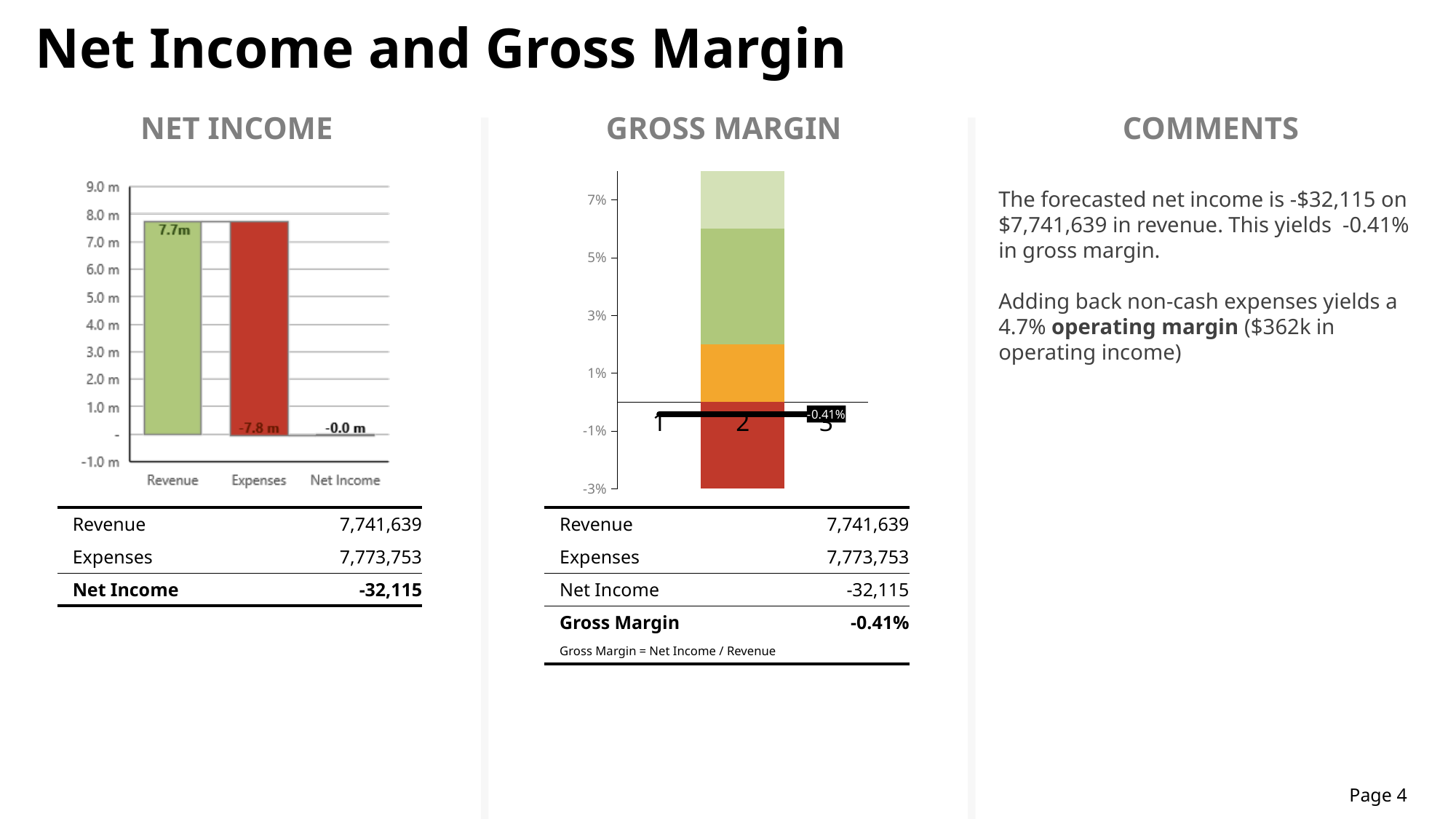
In the Net Income chart, what is the value shown for Expenses? -7.8 m In the Net Income chart, what is the value shown for Net Income? -0.0 m How many categories are shown on the x axis of the Net Income chart? 3 How many coloured bands make up the stacked bar in the Gross Margin chart? 4 In the Gross Margin chart, what value is printed on the label next to the horizontal marker line? -0.41% What kind of chart is the Net Income chart? bar chart In the Net Income chart, is the value for Revenue greater or less than 7.0 m? greater In the Net Income chart, which is larger, the value for Revenue or the value for Net Income? Revenue In the Net Income chart, what is the value shown for Revenue? 7.7m In the Gross Margin chart, is the marked gross margin value greater or less than 1%? less